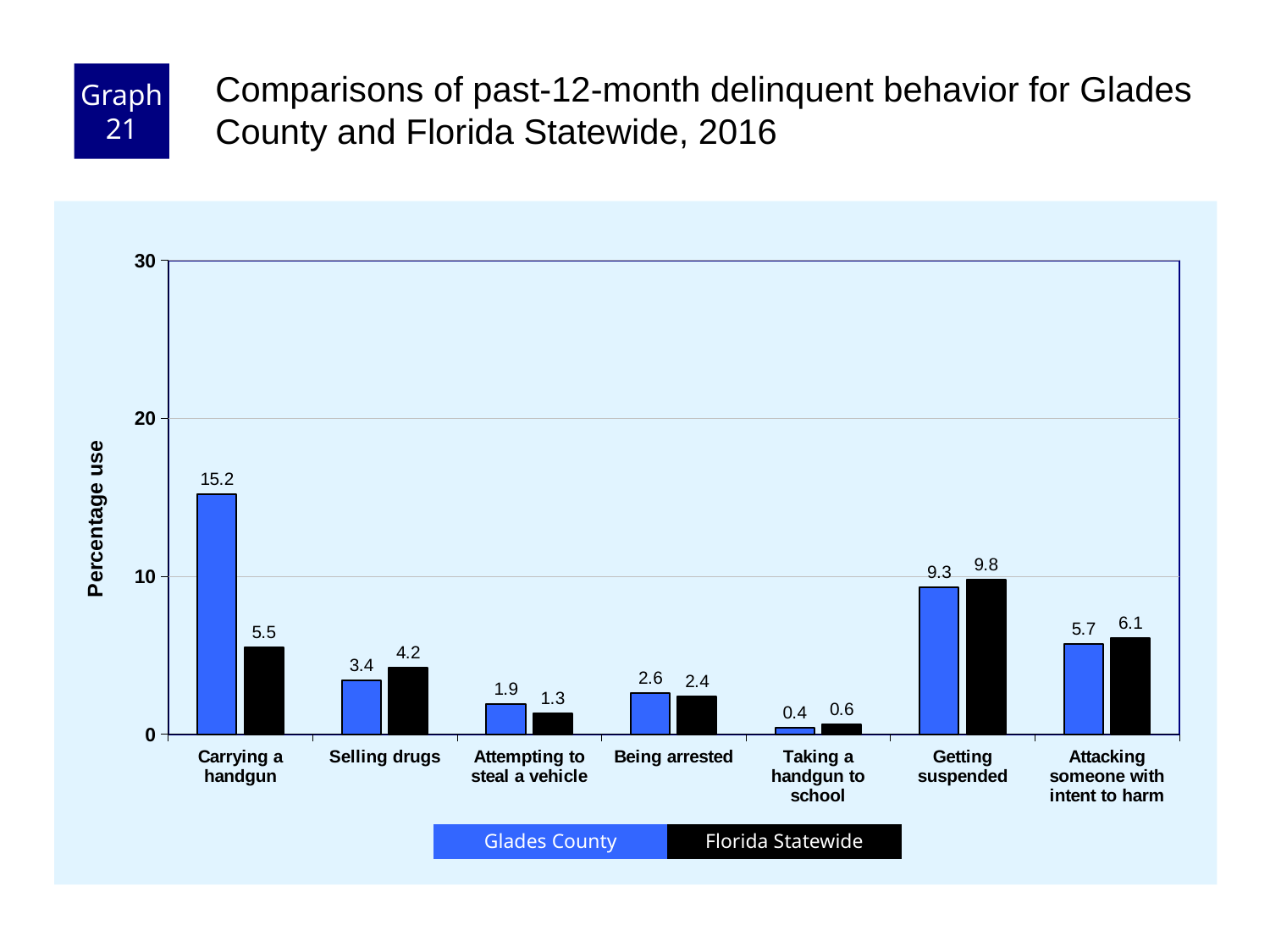
What kind of chart is shown on the slide? Bar chart What is the Glades County value for Taking a handgun to school? 0.4 Is the Glades County value for Carrying a handgun greater or less than 10? greater How many categories are shown on the x axis? 7 Which category has the highest Glades County value? Carrying a handgun What is the difference between the Florida Statewide and Glades County values for Selling drugs? 0.8 Which category has the lowest Florida Statewide value? Taking a handgun to school What is the difference between the Glades County and Florida Statewide values for Carrying a handgun? 9.7 What is the Glades County value for Carrying a handgun? 15.2 Which is larger for Attempting to steal a vehicle, Glades County or Florida Statewide? Glades County How many series does the legend list? 2 What is the Florida Statewide value for Getting suspended? 9.8